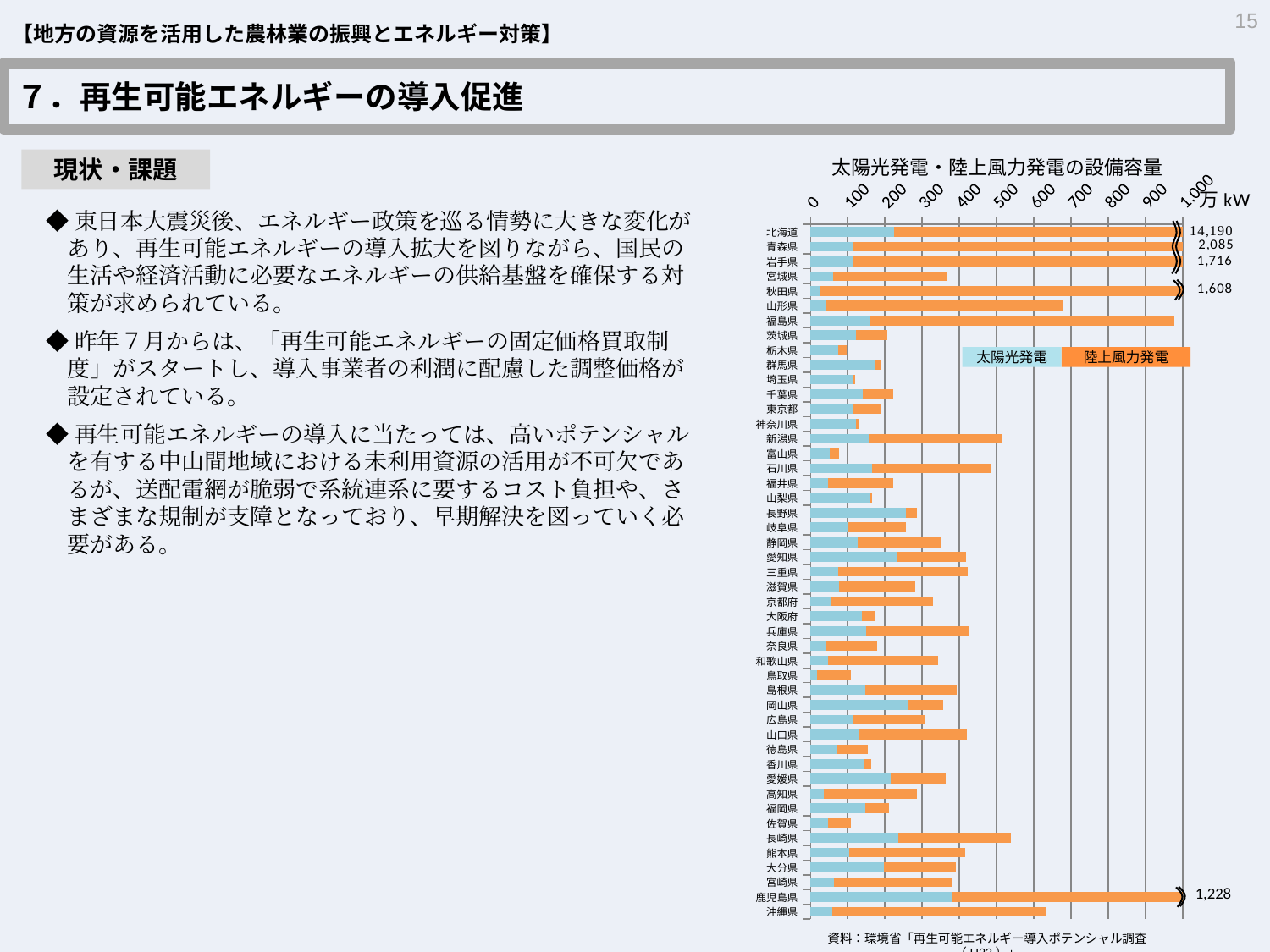
Which has the larger total bar, 福島県 or 茨城県? 福島県 What are the two series named in the chart's legend? 太陽光発電, 陸上風力発電 Is the total bar for 神奈川県 greater or less than 200? less What kind of chart is shown on the slide? bar chart Which prefecture has the highest total in the chart? 北海道 What is the title of the chart? 太陽光発電・陸上風力発電の設備容量 How many prefectures (categories) are plotted in the chart? 47 Is the total bar for 沖縄県 greater or less than 500? greater How many series does the chart's legend list? 2 What value is printed next to the bar for 青森県? 2,085 What value is printed next to the bar for 北海道? 14,190 What value is printed next to the bar for 鹿児島県? 1,228